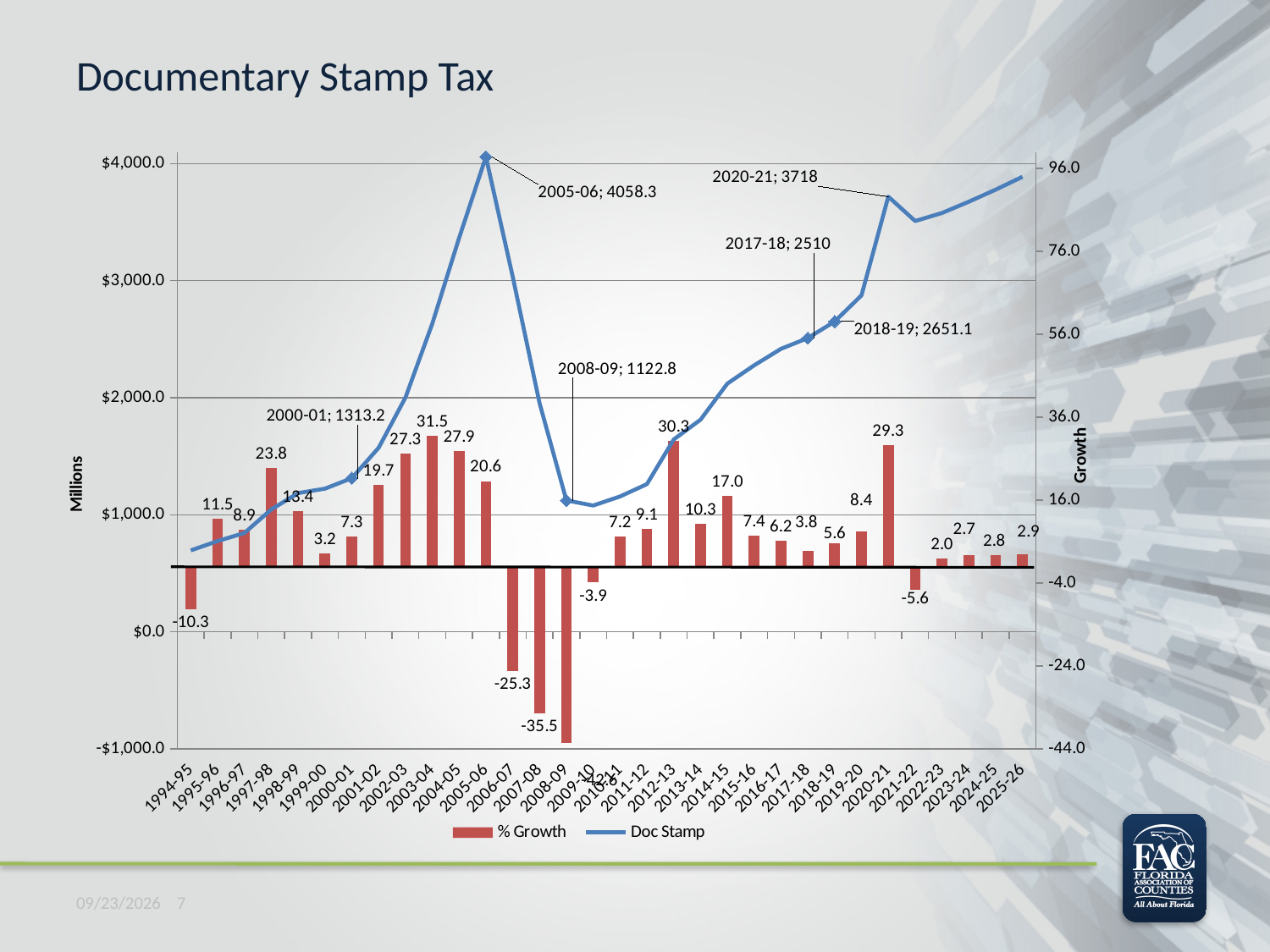
What is the % Growth value for 2003-04? 31.5 Is the Doc Stamp value for 2025-26 greater or less than $3,000.0? greater Which year has the larger % Growth, 2012-13 or 2020-21? 2012-13 Which year has the lowest % Growth? 2008-09 What is the Doc Stamp value for 2020-21? 3718 What kind of chart is shown on the slide? A combination bar and line chart How many fiscal years are shown on the x axis? 32 What is the Doc Stamp value for 2005-06? 4058.3 What is the % Growth value for 2007-08? -35.5 How many series does the legend list? 2 What is the difference between the Doc Stamp values for 2018-19 and 2017-18? 141.1 Which year has the highest % Growth? 2003-04